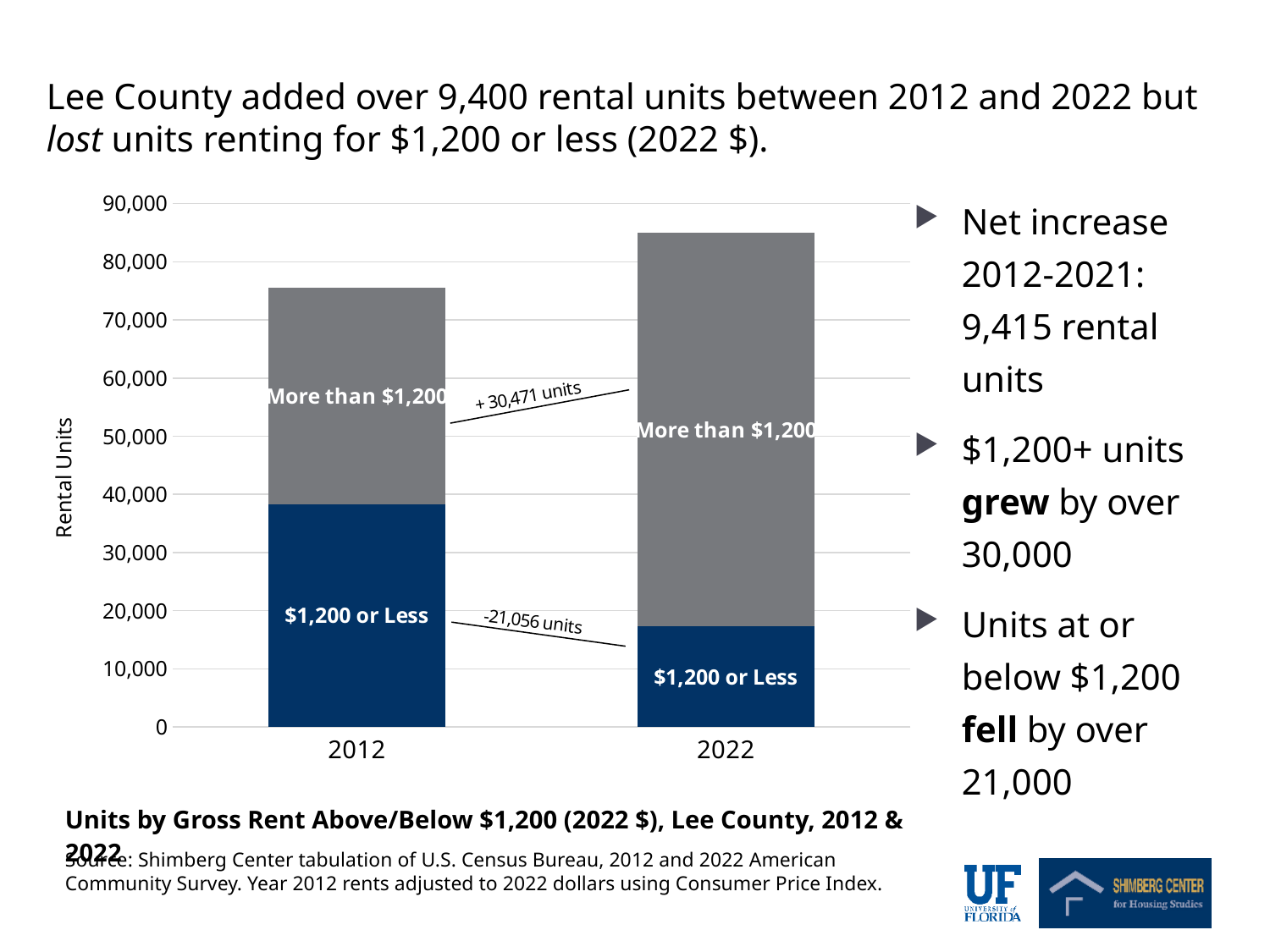
According to the annotation on the chart, by how many units did the '$1,200 or Less' segment change between 2012 and 2022? -21,056 units Which year has the larger '$1,200 or Less' segment, 2012 or 2022? 2012 How many rent categories are stacked in each bar of the chart? 2 How many years (categories) are shown on the x axis of the chart? 2 Is the total bar height for 2022 greater or less than 80,000? greater Which year has the taller total bar, 2012 or 2022? 2022 Which year has the larger 'More than $1,200' segment, 2012 or 2022? 2022 What is the label on the vertical axis of the chart? Rental Units According to the annotation on the chart, by how many units did the 'More than $1,200' segment change between 2012 and 2022? + 30,471 units What kind of chart is shown on the slide? stacked bar chart Is the '$1,200 or Less' value for 2022 greater or less than 20,000? less Is the '$1,200 or Less' value for 2012 greater or less than 30,000? greater